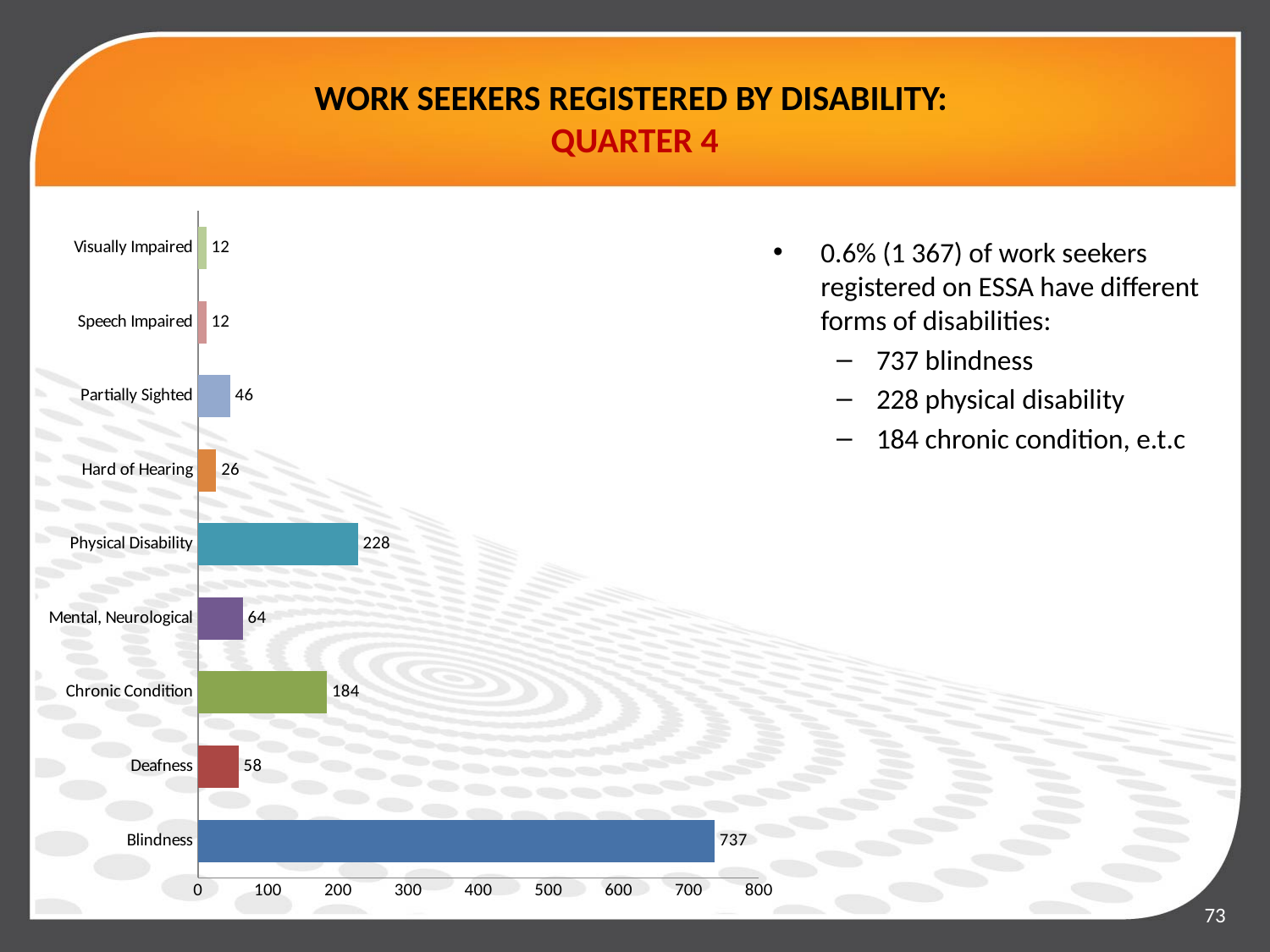
What kind of chart is shown on the slide? bar chart What is the value for Physical Disability? 228 Which is larger, the value for Partially Sighted or the value for Hard of Hearing? Partially Sighted What is the title of the slide containing the chart? WORK SEEKERS REGISTERED BY DISABILITY: QUARTER 4 What is the difference between the values for Blindness and Physical Disability? 509 Is the value for Chronic Condition greater or less than 200? less What is the difference between the values for Mental, Neurological and Deafness? 6 What is the value for Blindness? 737 Which category has the highest value? Blindness What is the value for Hard of Hearing? 26 How many categories are shown in the chart? 9 What is the value for Chronic Condition? 184